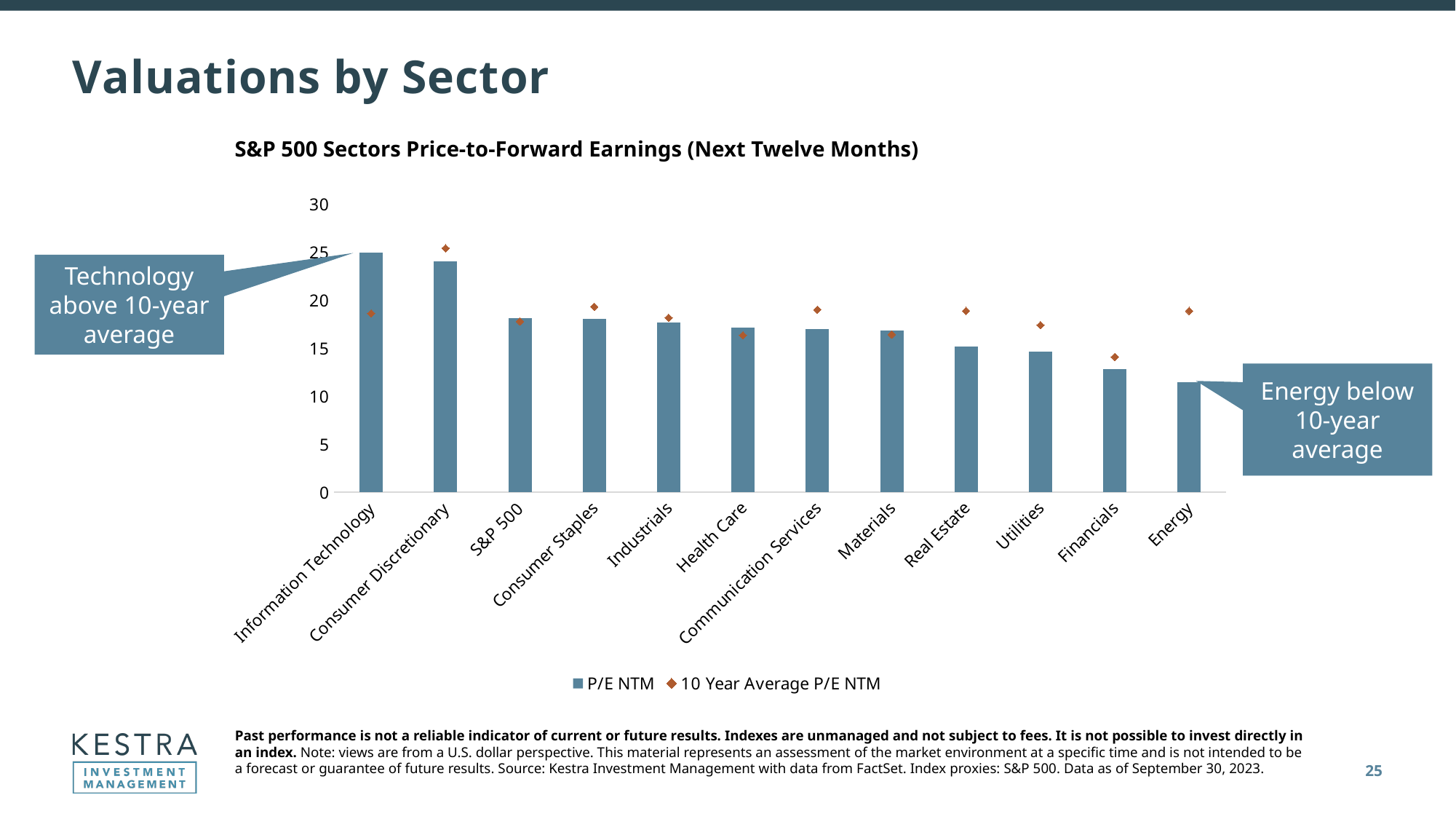
Which category has the highest P/E NTM bar? Information Technology Is the P/E NTM value for Energy greater or less than 15? less What type of chart is shown on the slide? Bar chart What are the two series named in the chart legend? P/E NTM and 10 Year Average P/E NTM What is the title of the chart? S&P 500 Sectors Price-to-Forward Earnings (Next Twelve Months) How many categories are shown along the x axis of the chart? 12 Is the P/E NTM value for Health Care greater or less than 20? less Is the P/E NTM value for Information Technology greater or less than 20? greater Which category has the lowest P/E NTM bar? Energy How many series does the chart legend list? 2 Do the P/E NTM bars rise or fall moving from left to right along the x axis? Fall Which has a larger P/E NTM bar, Consumer Discretionary or Financials? Consumer Discretionary